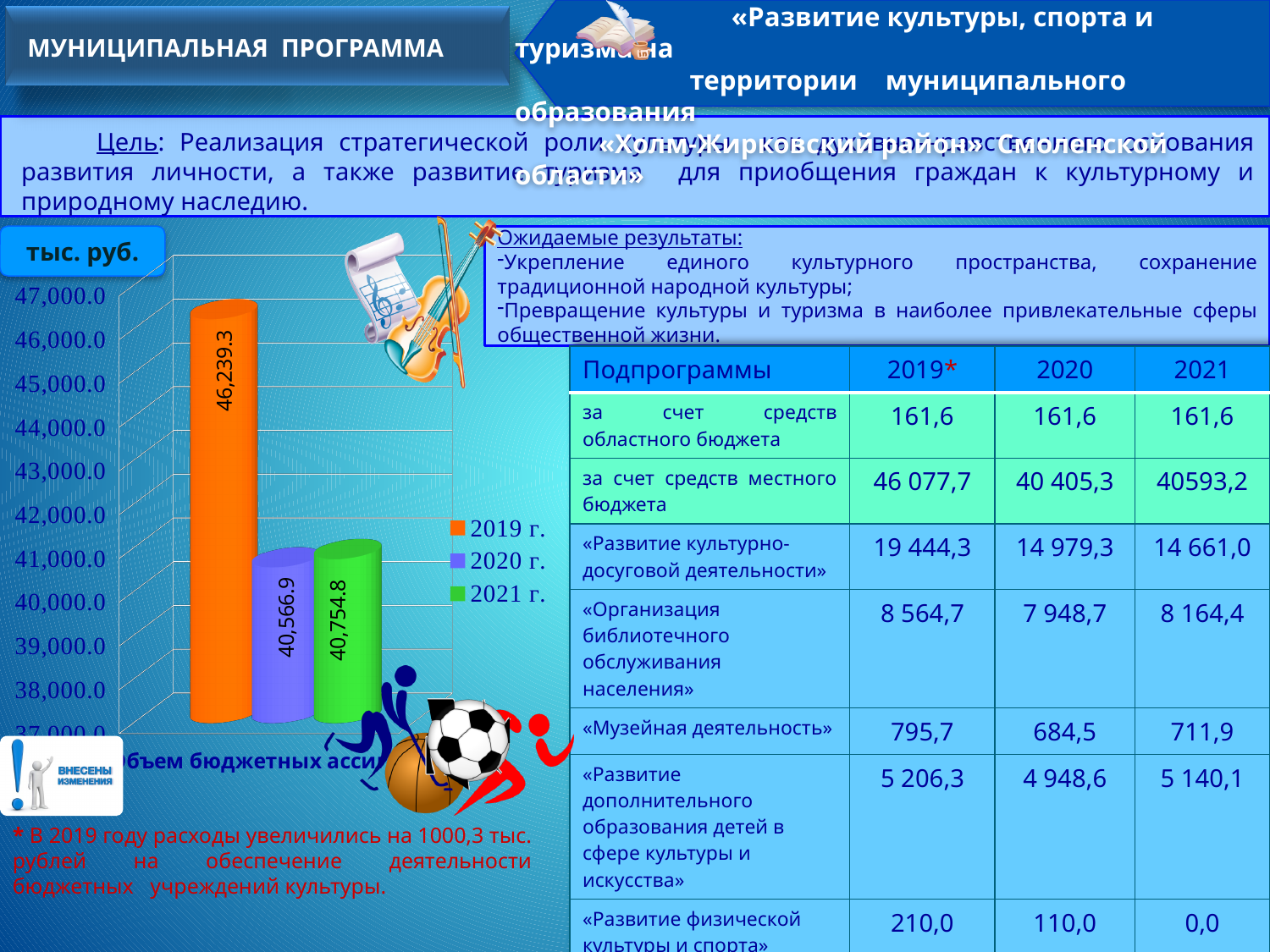
What is the value for 2019 г. in the bar chart? 46,239.3 What type of chart is shown on the left of the slide? bar chart Is the value for 2020 г. in the bar chart greater or less than 41,000.0? less Which year has the highest value in the bar chart? 2019 г. What is the difference between the values for 2019 г. and 2020 г. in the bar chart? 5,672.4 How many entries does the legend of the bar chart list? 3 What is the value for 2021 г. in the bar chart? 40,754.8 Which is larger in the bar chart, the value for 2019 г. or the value for 2021 г.? 2019 г. Which year has the lowest value in the bar chart? 2020 г. What is the difference between the values for 2021 г. and 2020 г. in the bar chart? 187.9 How many bars are plotted in the bar chart? 3 What is the value for 2020 г. in the bar chart? 40,566.9